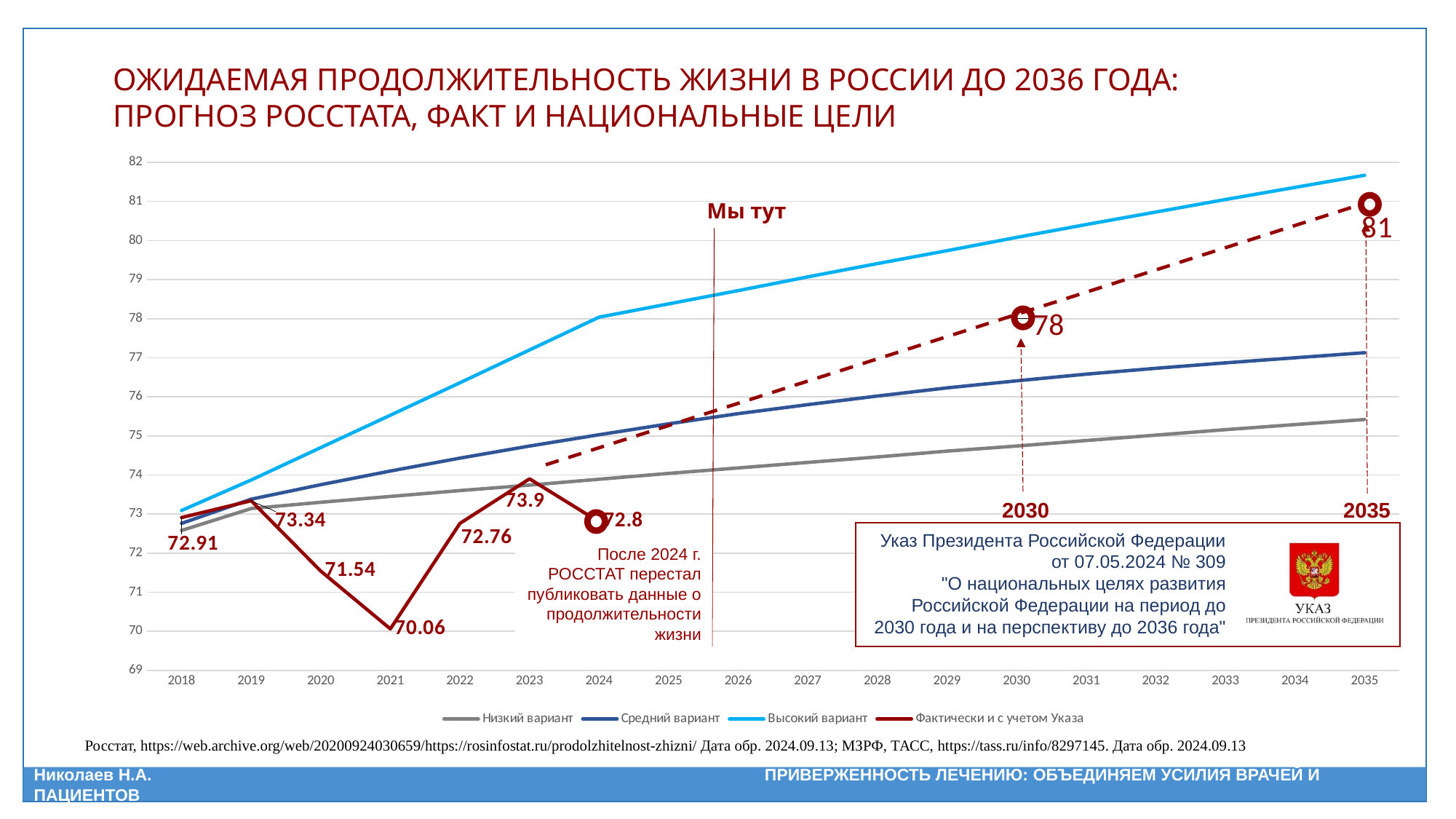
How many series does the legend list? 4 What target value is marked on the chart for 2035? 81 By how much does the 2035 target (81) exceed the 2030 target (78)? 3 What is the difference between the 2023 value (73.9) and the 2021 value (70.06) of the 'Фактически и с учетом Указа' series? 3.84 Is the value of the 'Низкий вариант' series in 2035 greater or less than 76? less What target value is marked on the chart for 2030? 78 In which year does the 'Фактически и с учетом Указа' series reach its lowest labelled value? 2021 What is the value of the 'Фактически и с учетом Указа' series in 2018? 72.91 What is the value of the 'Фактически и с учетом Указа' series in 2021? 70.06 What kind of chart is shown on the slide? line chart Which year has the higher value on the 'Фактически и с учетом Указа' series: 2019 or 2022? 2019 Is the value of the 'Высокий вариант' series in 2035 greater or less than 81? greater